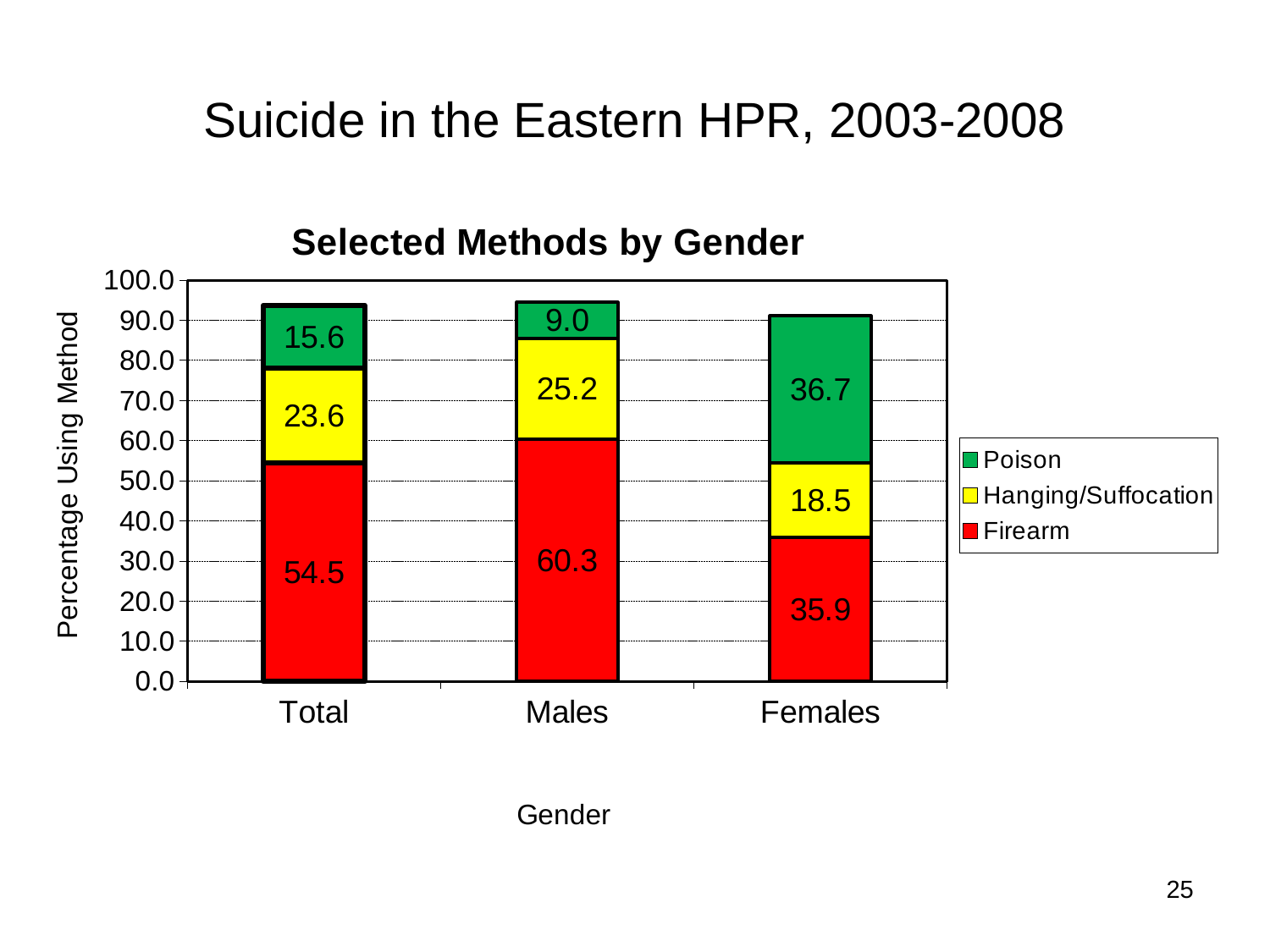
What is the Poison value for Males? 9.0 What is the difference between the Firearm values for Males and Females? 24.4 What kind of chart is shown on the slide? Stacked bar chart What is the Hanging/Suffocation value for Total? 23.6 What is the total of the stacked bar for Males? 94.5 How many gender categories are shown on the x axis? 3 Which is larger for Females, the Poison value or the Firearm value? Poison What is the Poison value for Females? 36.7 Which gender category has the lowest Poison value? Males Which gender category has the highest Firearm value? Males How many series does the legend list? 3 What is the Firearm value for Males? 60.3